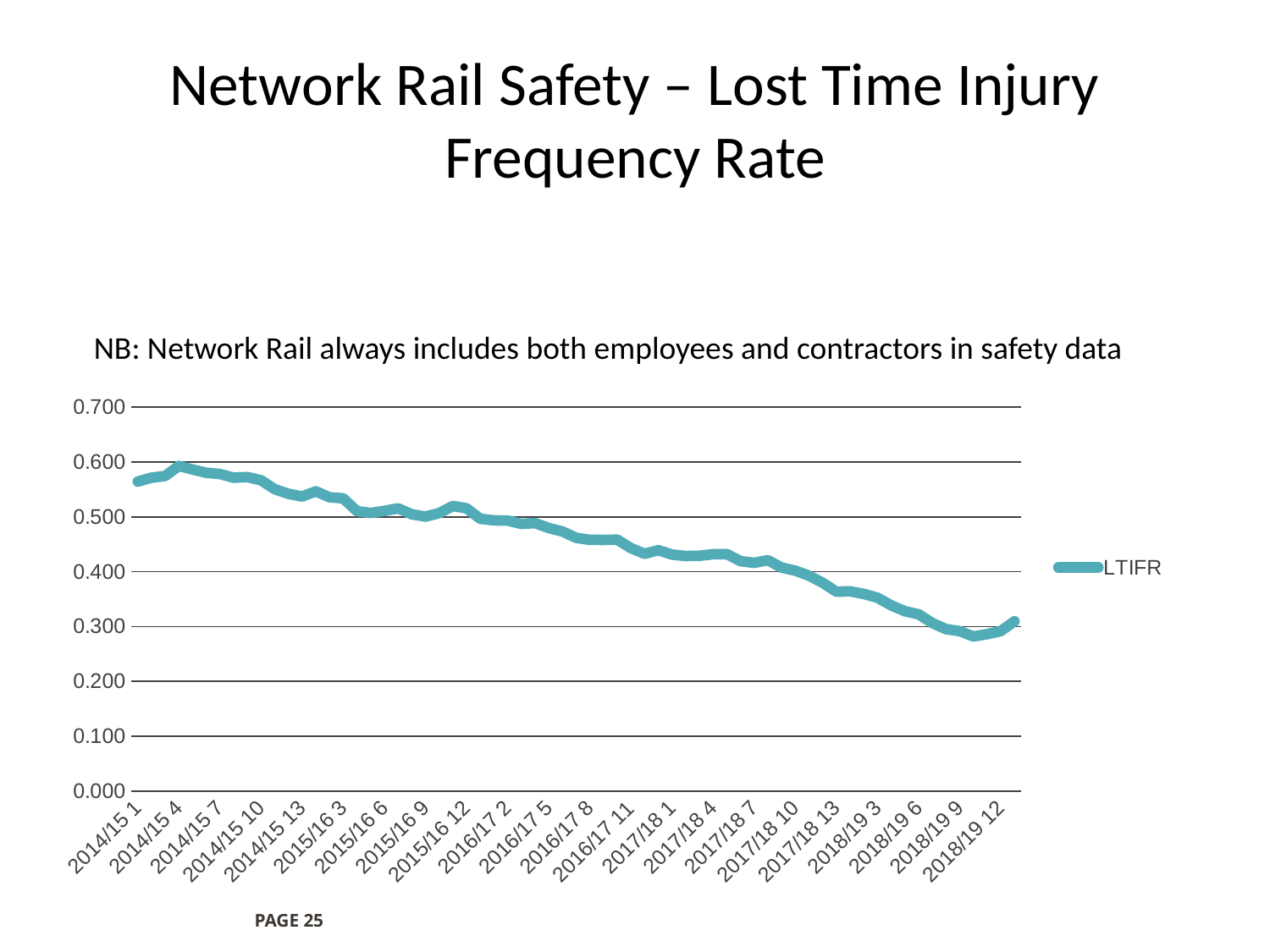
Is the LTIFR value for 2014/15 1 greater or less than 0.500? greater What is the name of the series shown in the legend? LTIFR Which is larger, the LTIFR value for 2014/15 1 or for 2018/19 12? 2014/15 1 Which labelled period on the x axis has the highest LTIFR value? 2014/15 4 Is the LTIFR value for 2018/19 6 greater or less than 0.400? less How many series does the legend list? 1 What kind of chart is shown on the slide? line chart Is the LTIFR value for 2014/15 4 greater or less than 0.500? greater Do the LTIFR values generally rise or fall from 2014/15 1 to 2018/19 12? fall What is the highest value shown on the y axis? 0.700